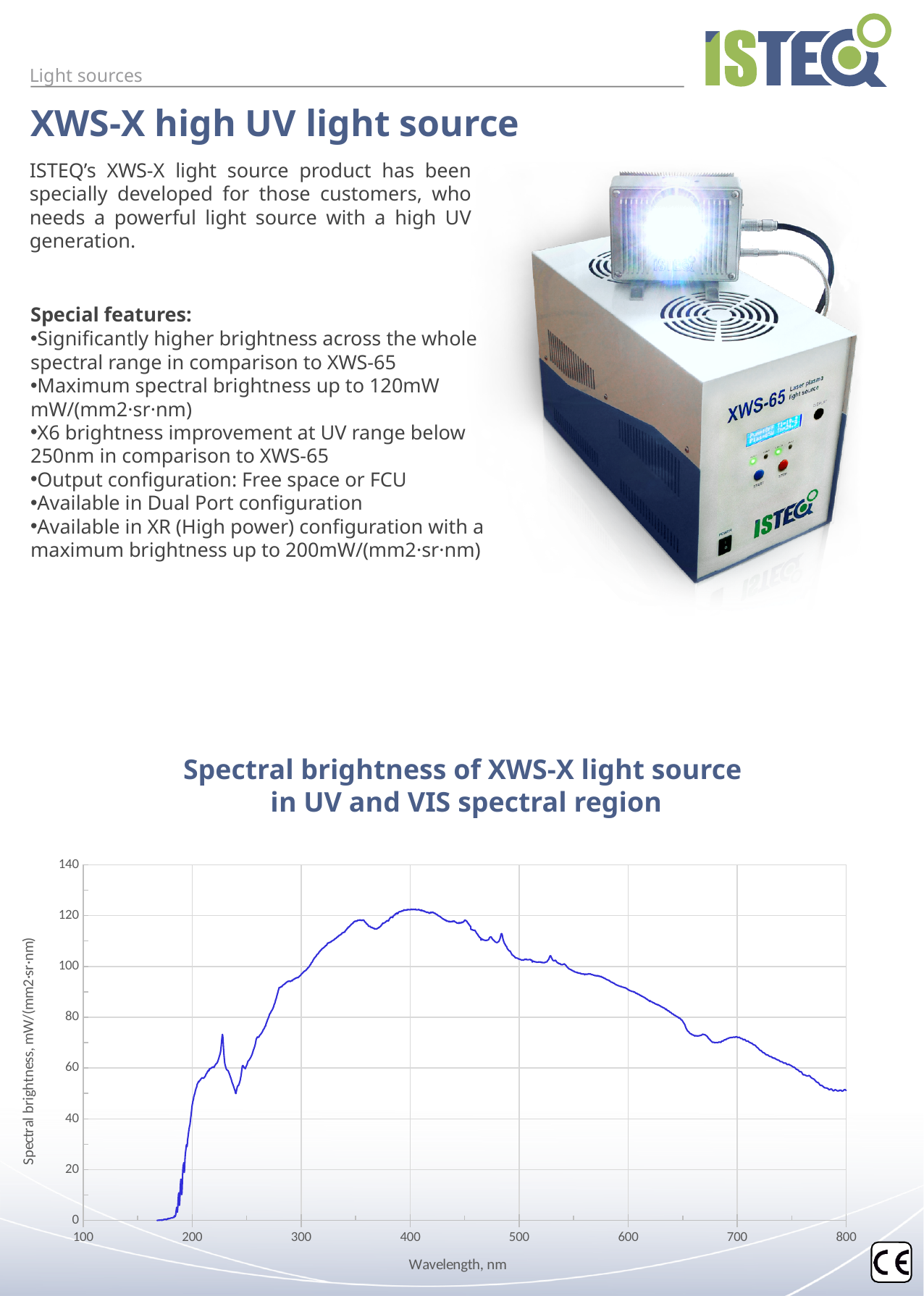
Is the spectral brightness at 200 nm greater or less than 60? less Is the spectral brightness at 800 nm greater or less than 60? less Is the spectral brightness at 400 nm greater or less than 100? greater Does the spectral brightness rise or fall between 200 nm and 400 nm? rise What is the title of the chart? Spectral brightness of XWS-X light source in UV and VIS spectral region What kind of chart is shown on the slide? line chart Does the spectral brightness rise or fall between 400 nm and 800 nm? fall What is the label of the x axis of the chart? Wavelength, nm Which is larger, the spectral brightness at 400 nm or at 800 nm? 400 nm